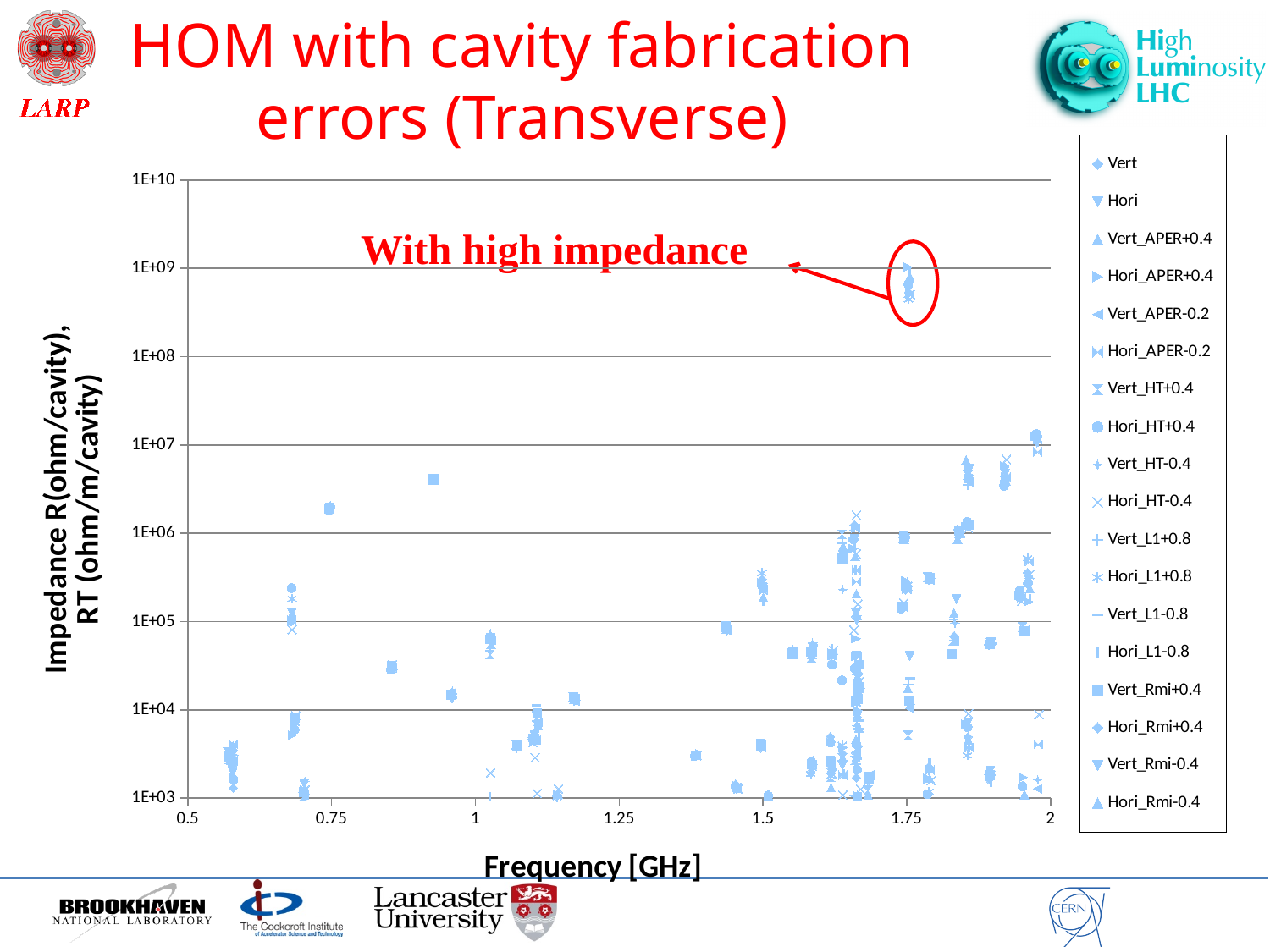
Is the impedance of the cluster of points near 0.57 GHz greater or less than 1E+04? less How many series does the legend list? 18 Is the impedance of the cluster of points near 0.75 GHz greater or less than 1E+06? greater Is the impedance of the points near 1.17 GHz greater or less than 1E+05? less What kind of chart is shown on the slide? scatter chart What is the title of the x axis? Frequency [GHz] What text is written in the annotation pointing to the circled points? With high impedance